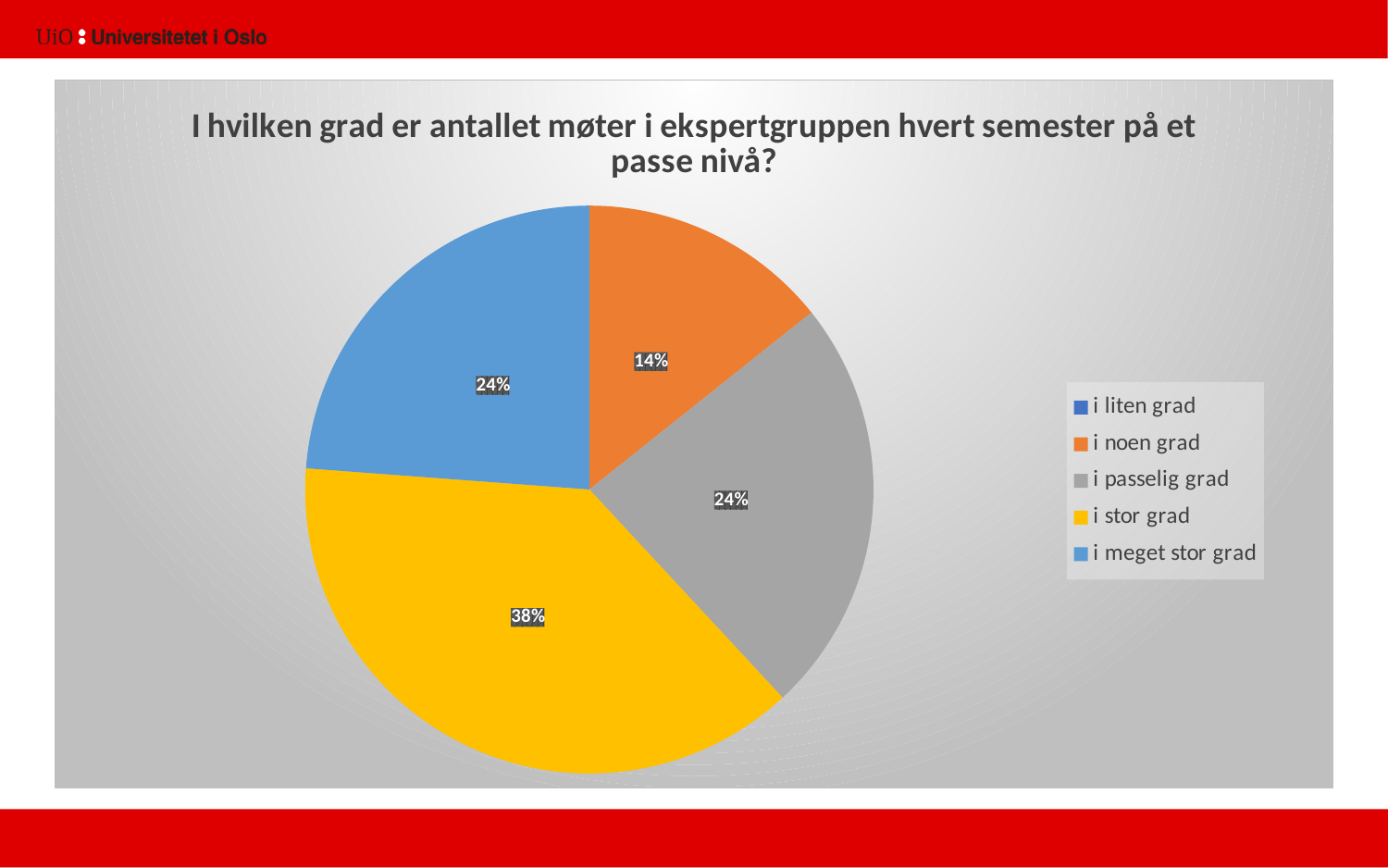
Which of the plotted slices is the smallest? i noen grad Which category has the largest slice of the pie? i stor grad What is the difference in percentage points between 'i stor grad' and 'i noen grad'? 24 percentage points What colour is the 'i stor grad' slice? Yellow What percentage of the pie is the 'i stor grad' slice? 38% What is the title of the chart? I hvilken grad er antallet møter i ekspertgruppen hvert semester på et passe nivå? What value is shown for 'i passelig grad'? 24% Which is larger, the slice for 'i stor grad' or the slice for 'i passelig grad'? i stor grad What kind of chart is shown on the slide? Pie chart How many entries does the legend list? 5 What value is shown for 'i meget stor grad'? 24% What value is shown for 'i noen grad'? 14%